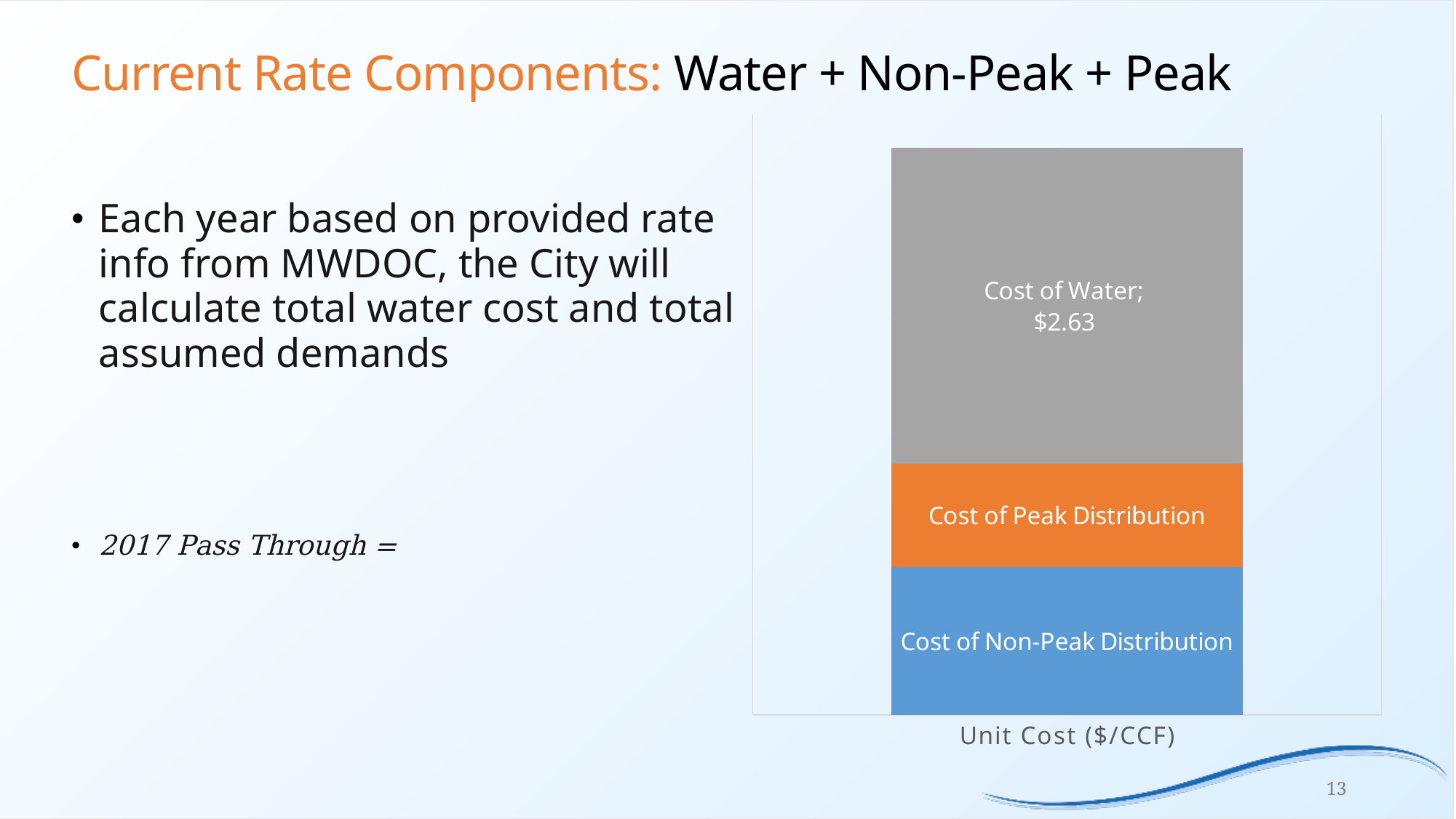
How many segments make up the stacked bar? 3 What is the label on the horizontal axis of the chart? Unit Cost ($/CCF) Which segment of the stacked bar is the smallest? Cost of Peak Distribution What is the value shown for the Cost of Water segment? $2.63 Which segment is larger: Cost of Non-Peak Distribution or Cost of Peak Distribution? Cost of Non-Peak Distribution Which segment of the stacked bar is the largest? Cost of Water What colour is the Cost of Water segment? Gray What kind of chart is shown on the slide? Stacked bar chart Which segment is larger: Cost of Water or Cost of Peak Distribution? Cost of Water How many bars are plotted in the chart? 1